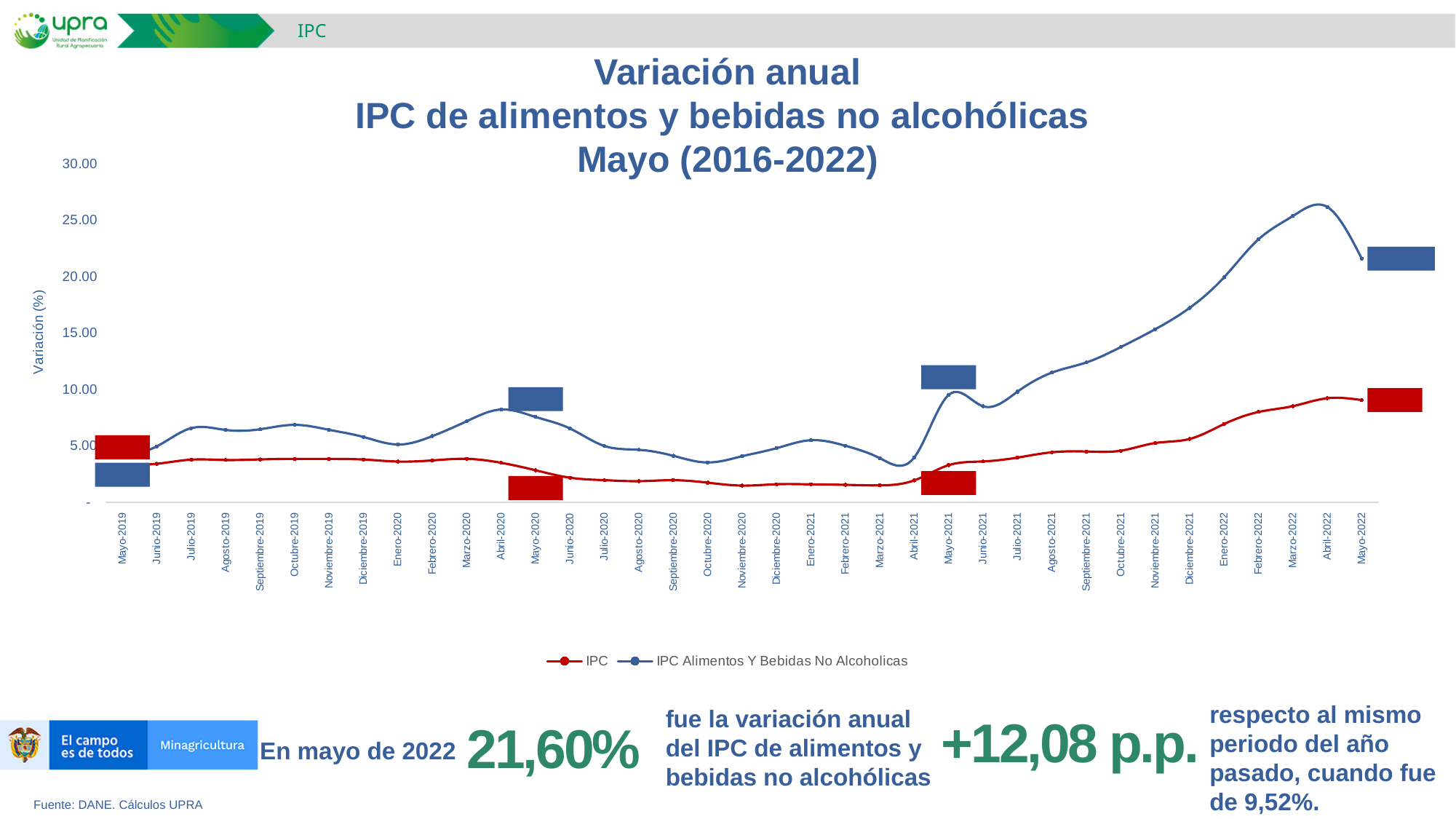
In which month does the IPC Alimentos Y Bebidas No Alcoholicas series reach its highest value? Abril-2022 Does the IPC Alimentos Y Bebidas No Alcoholicas series rise or fall between Junio-2021 and Abril-2022? rise Is the value of IPC Alimentos Y Bebidas No Alcoholicas in Octubre-2020 greater or less than 5.00? less In Mayo-2022, which series has the larger value, IPC or IPC Alimentos Y Bebidas No Alcoholicas? IPC Alimentos Y Bebidas No Alcoholicas What kind of chart is shown on the slide? line chart How many monthly points are plotted along the x axis, from Mayo-2019 to Mayo-2022? 37 How many series does the legend list? 2 Is the value of IPC Alimentos Y Bebidas No Alcoholicas in Diciembre-2021 greater or less than 15.00? greater What is the title of the y axis? Variación (%) Is the value of IPC Alimentos Y Bebidas No Alcoholicas in Mayo-2022 greater or less than 20.00? greater